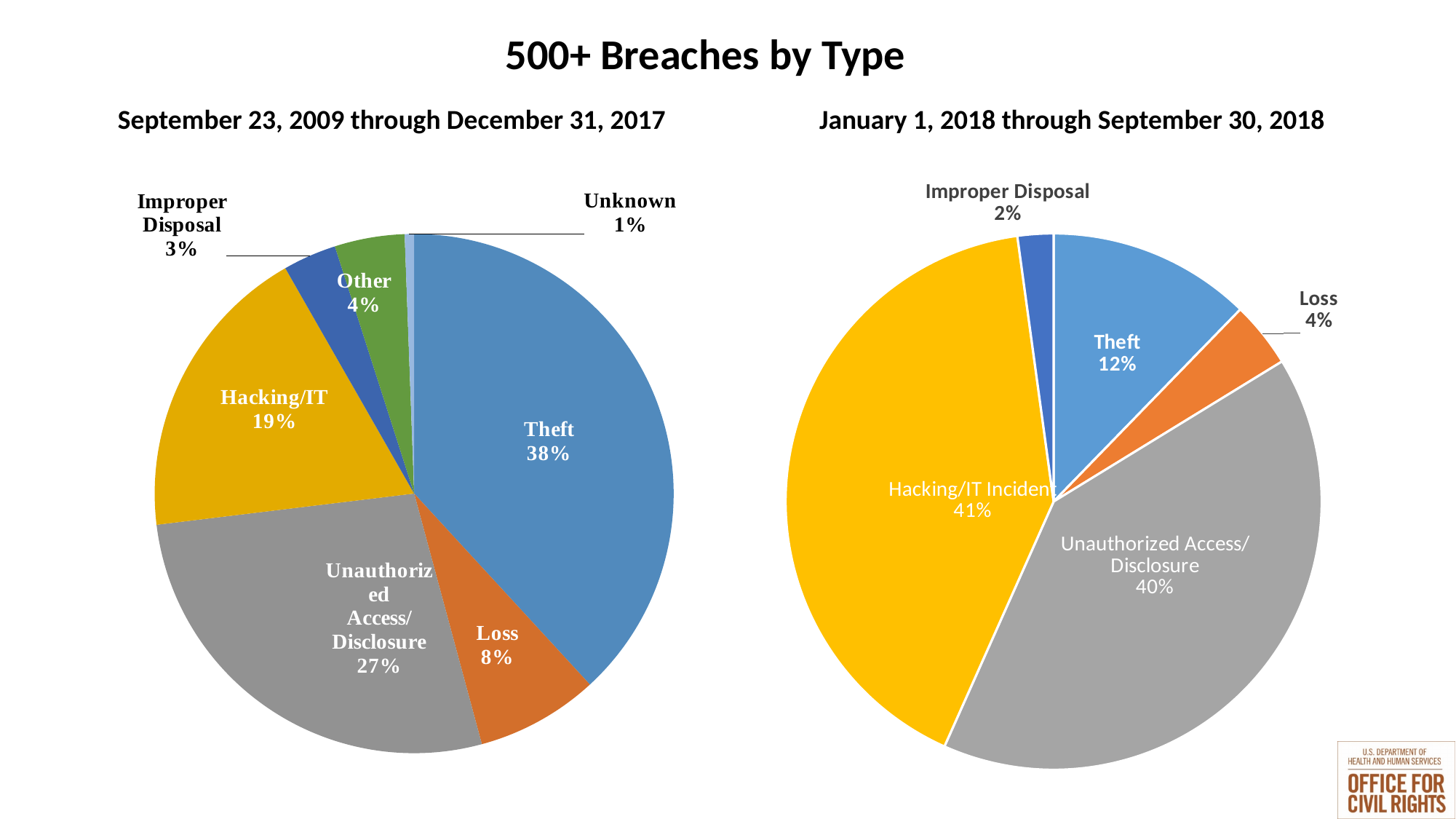
How many slices does the September 23, 2009 through December 31, 2017 pie chart have? 7 How many slices does the January 1, 2018 through September 30, 2018 pie chart have? 5 In the January 1, 2018 through September 30, 2018 pie chart, which breach type has the largest share? Hacking/IT Incident In the September 23, 2009 through December 31, 2017 pie chart, which breach type has the largest share? Theft In the January 1, 2018 through September 30, 2018 pie chart, which breach type has the smallest share? Improper Disposal What type of chart is used on the left side of the slide? Pie chart In the September 23, 2009 through December 31, 2017 pie chart, which breach type has the smallest share? Unknown In the January 1, 2018 through September 30, 2018 pie chart, which is larger: Theft or Loss? Theft In the January 1, 2018 through September 30, 2018 pie chart, what share of breaches is Unauthorized Access/Disclosure? 40% In the September 23, 2009 through December 31, 2017 pie chart, what share of breaches is Theft? 38% In the September 23, 2009 through December 31, 2017 pie chart, what is the difference in percentage points between Theft and Hacking/IT? 19 What is the main title of the slide? 500+ Breaches by Type